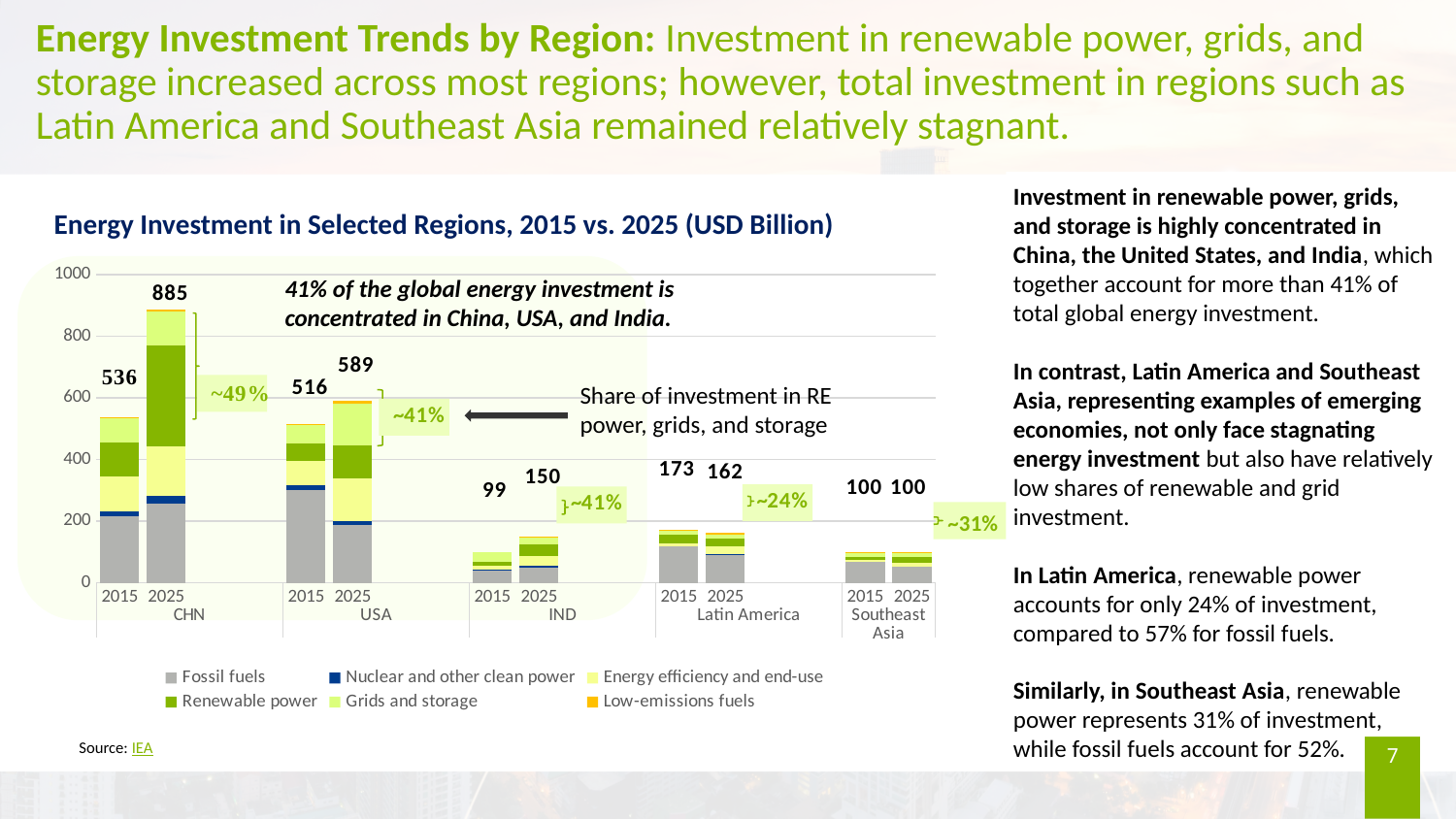
Which region and year has the lowest total energy investment? IND 2015 Which is larger: Latin America's total investment in 2015 or in 2025? 2015 What is the total energy investment for China (CHN) in 2025? 885 How many series does the legend list? 6 Which region and year has the highest total energy investment? CHN 2025 What is the total energy investment for the USA in 2015? 516 What kind of chart is shown? Stacked bar chart By how much did China's (CHN) total energy investment increase from 2015 to 2025? 349 What is the title of the chart? Energy Investment in Selected Regions, 2015 vs. 2025 (USD Billion) What is the difference between Latin America's total investment in 2015 and 2025? 11 What is the total energy investment for India (IND) in 2025? 150 How many regions are shown on the x axis? 5